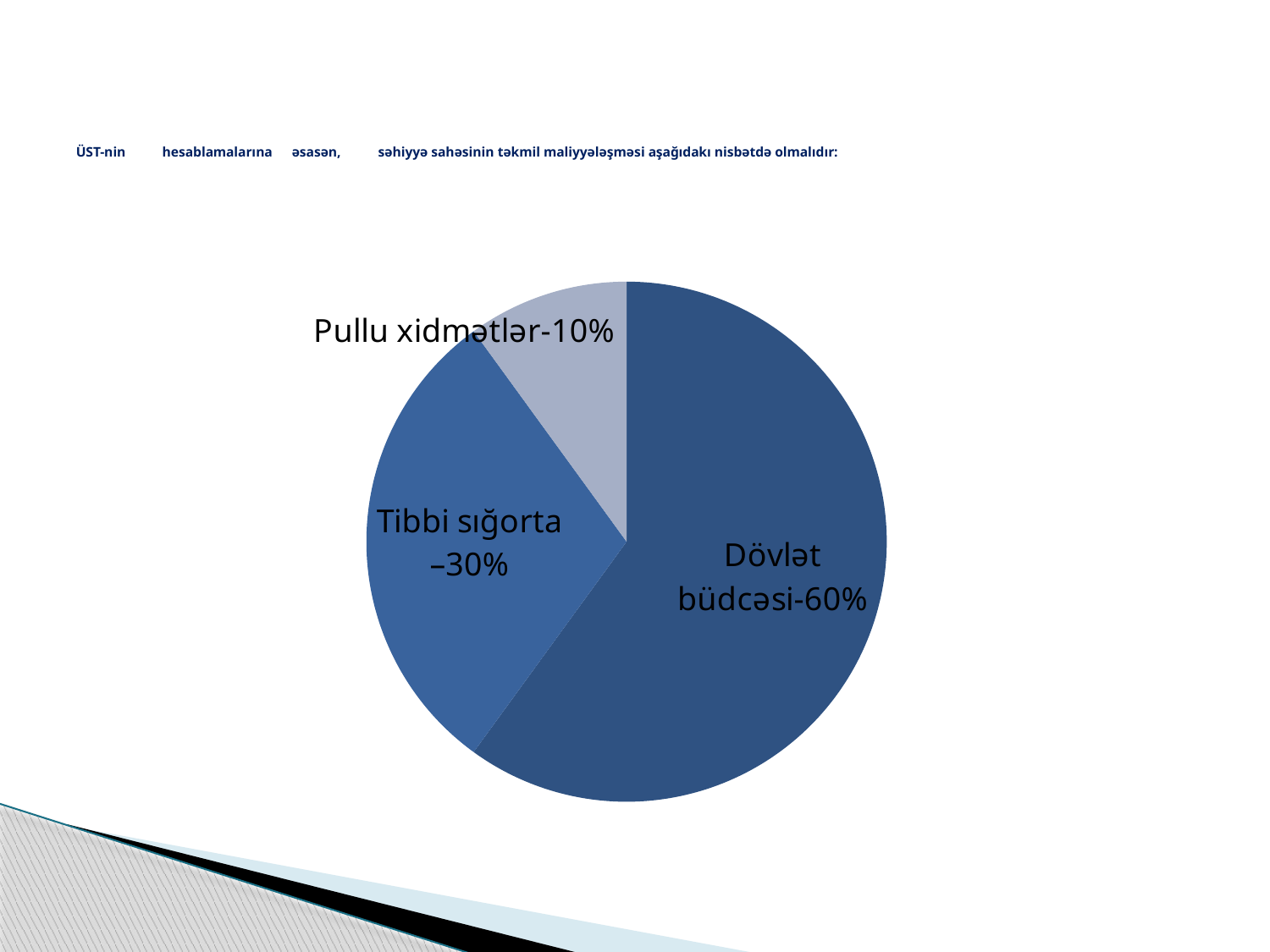
How many slices does the pie chart have? 3 What share of the pie is labelled Dövlət büdcəsi? 60% What is the combined share of the Tibbi sığorta and Pullu xidmətlər slices? 40% Which slice of the pie chart is the smallest? Pullu xidmətlər Which is larger, the Tibbi sığorta slice or the Pullu xidmətlər slice? Tibbi sığorta Which slice of the pie chart is shown in the lightest colour? Pullu xidmətlər Which slice of the pie chart is the largest? Dövlət büdcəsi What is the difference in percentage points between the Dövlət büdcəsi slice and the Tibbi sığorta slice? 30% What share of the pie is labelled Pullu xidmətlər? 10% What share of the pie is labelled Tibbi sığorta? 30% What is the difference in percentage points between the Tibbi sığorta slice and the Pullu xidmətlər slice? 20% What kind of chart is shown on the slide? pie chart